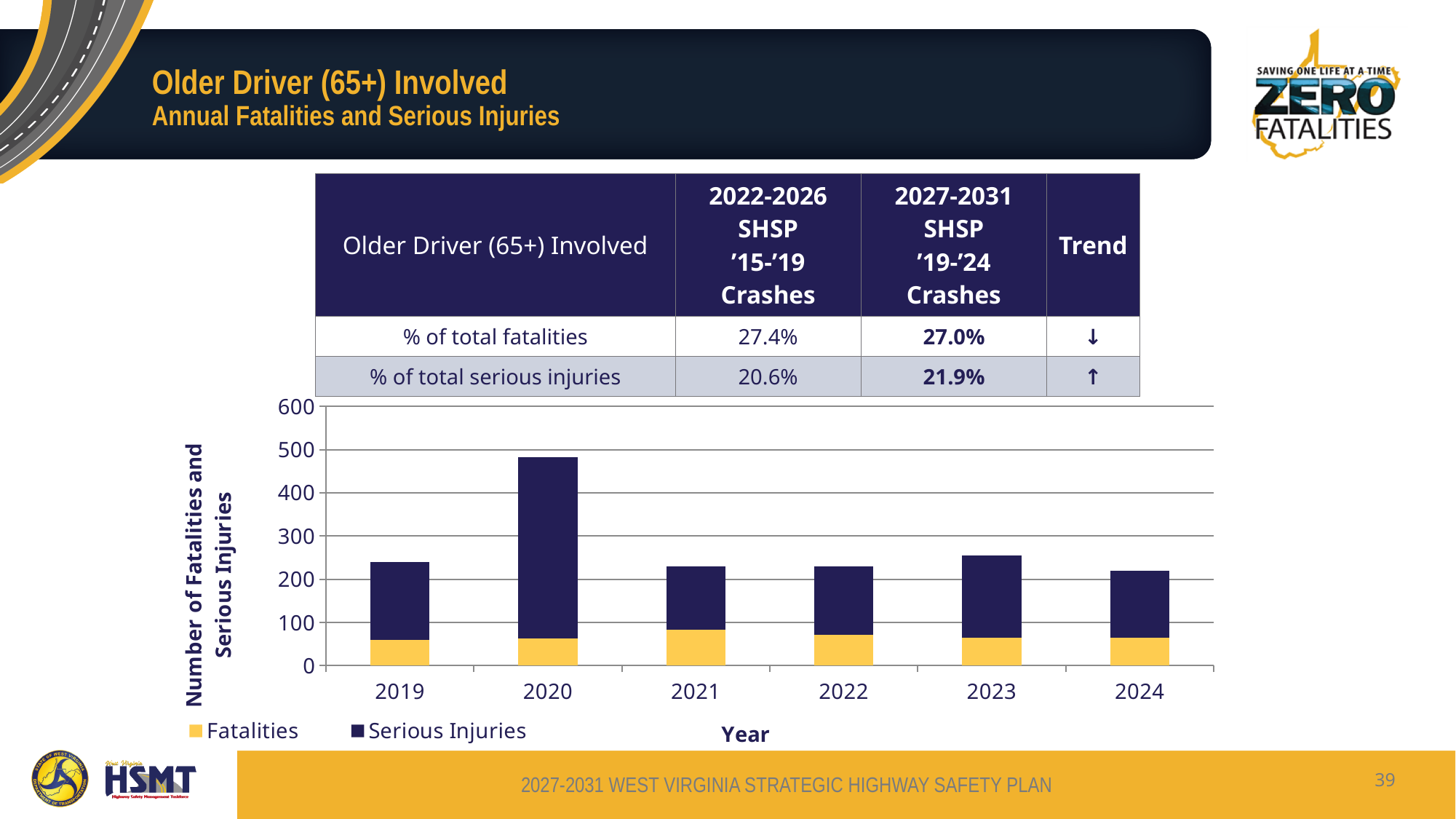
How many years are shown on the x axis of the chart? 6 Is the Fatalities value for 2021 greater or less than 100? less What colour represents Fatalities in the chart? Yellow How many series does the chart legend list? 2 Which is larger, the total bar for 2020 or the total bar for 2023? 2020 Which year has the highest total of fatalities and serious injuries? 2020 Is the total bar for 2019 greater or less than 300? less Is the total bar for 2024 greater or less than 200? greater What is the title of the y axis of the chart? Number of Fatalities and Serious Injuries Which series is larger in every year, Fatalities or Serious Injuries? Serious Injuries What kind of chart is shown on the slide? Stacked bar chart